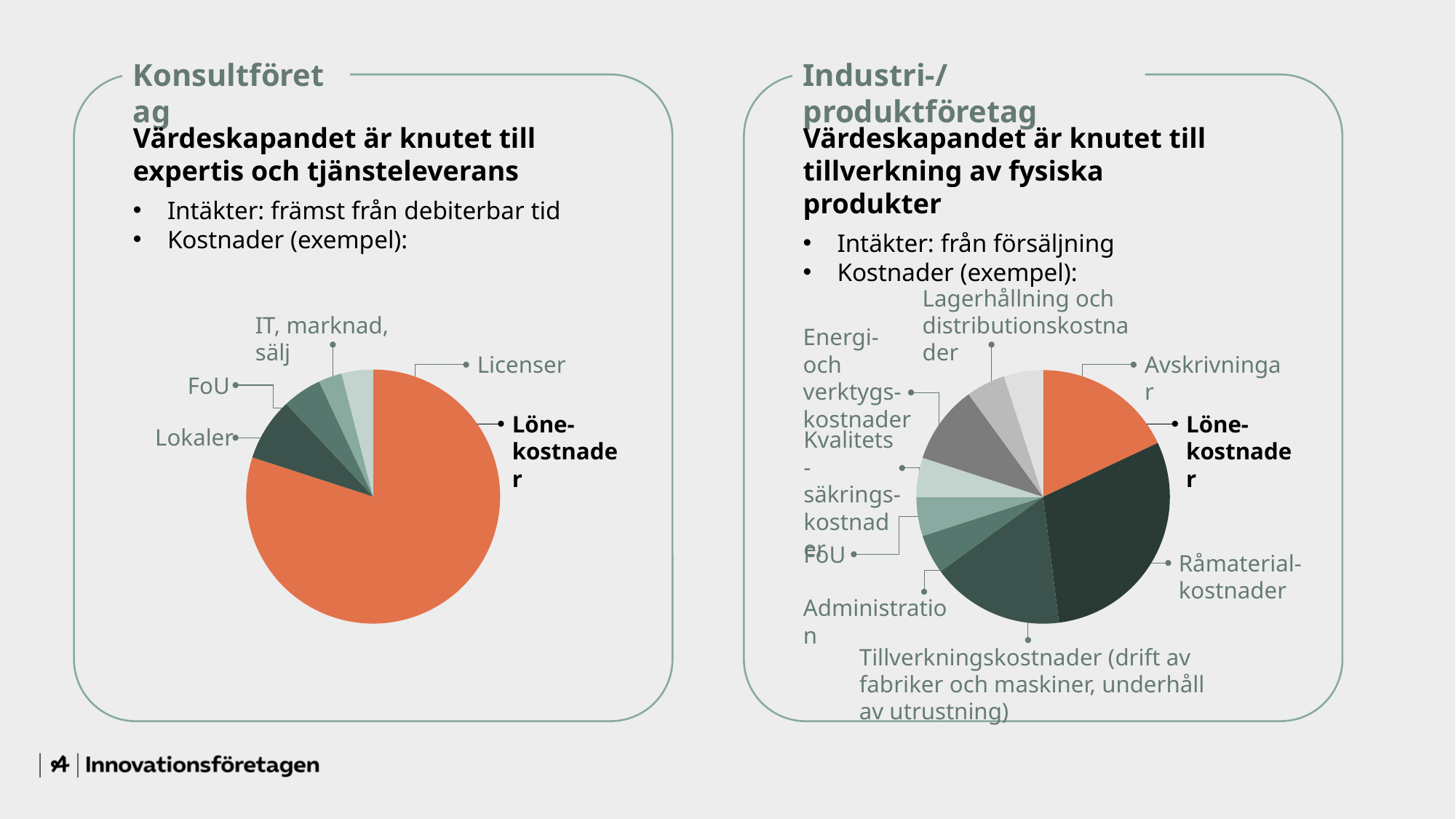
Which cost category label appears in bold in both pie charts? Lönekostnader In the Konsultföretag pie chart, how many cost categories (slices) are labelled? 5 What kind of chart is shown in the Konsultföretag box? Pie chart What kind of chart is shown in the Industri-/produktföretag box? Pie chart In the Konsultföretag pie chart, what colour is the Lönekostnader slice? Orange How many charts are on the slide? 2 In the Konsultföretag pie chart, which slice is larger, Lönekostnader or FoU? Lönekostnader In the Konsultföretag pie chart, which cost category has the largest slice? Lönekostnader In the Industri-/produktföretag pie chart, how many cost categories (slices) are labelled? 9 In the Konsultföretag pie chart, which slice is larger, Lönekostnader or Lokaler? Lönekostnader